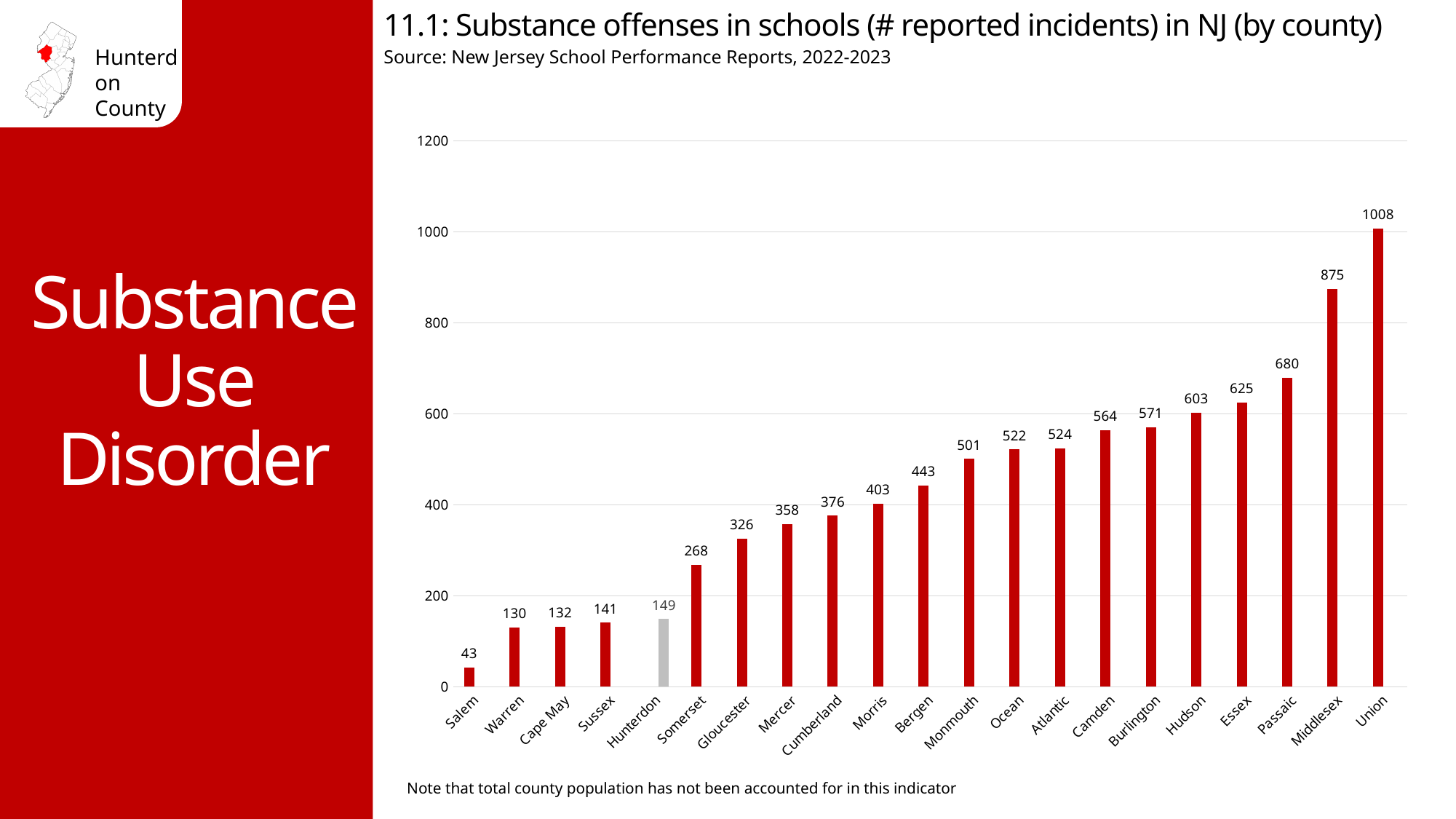
Do the values rise or fall moving from left to right along the x axis? Rise How many counties are shown on the chart? 21 What is the number of reported incidents for Middlesex County? 875 Which county's bar is shown in grey rather than red? Hunterdon What is the number of reported substance offense incidents in schools for Hunterdon County? 149 Which county has more reported incidents, Bergen or Morris? Bergen Is the value for Passaic greater or less than 600? greater Which county has the lowest number of reported substance offense incidents in schools? Salem What is the difference in reported incidents between Hunterdon and Salem? 106 What is the difference in reported incidents between Union and Middlesex? 133 What kind of chart is used on this slide? Bar chart Which county has the highest number of reported substance offense incidents in schools? Union